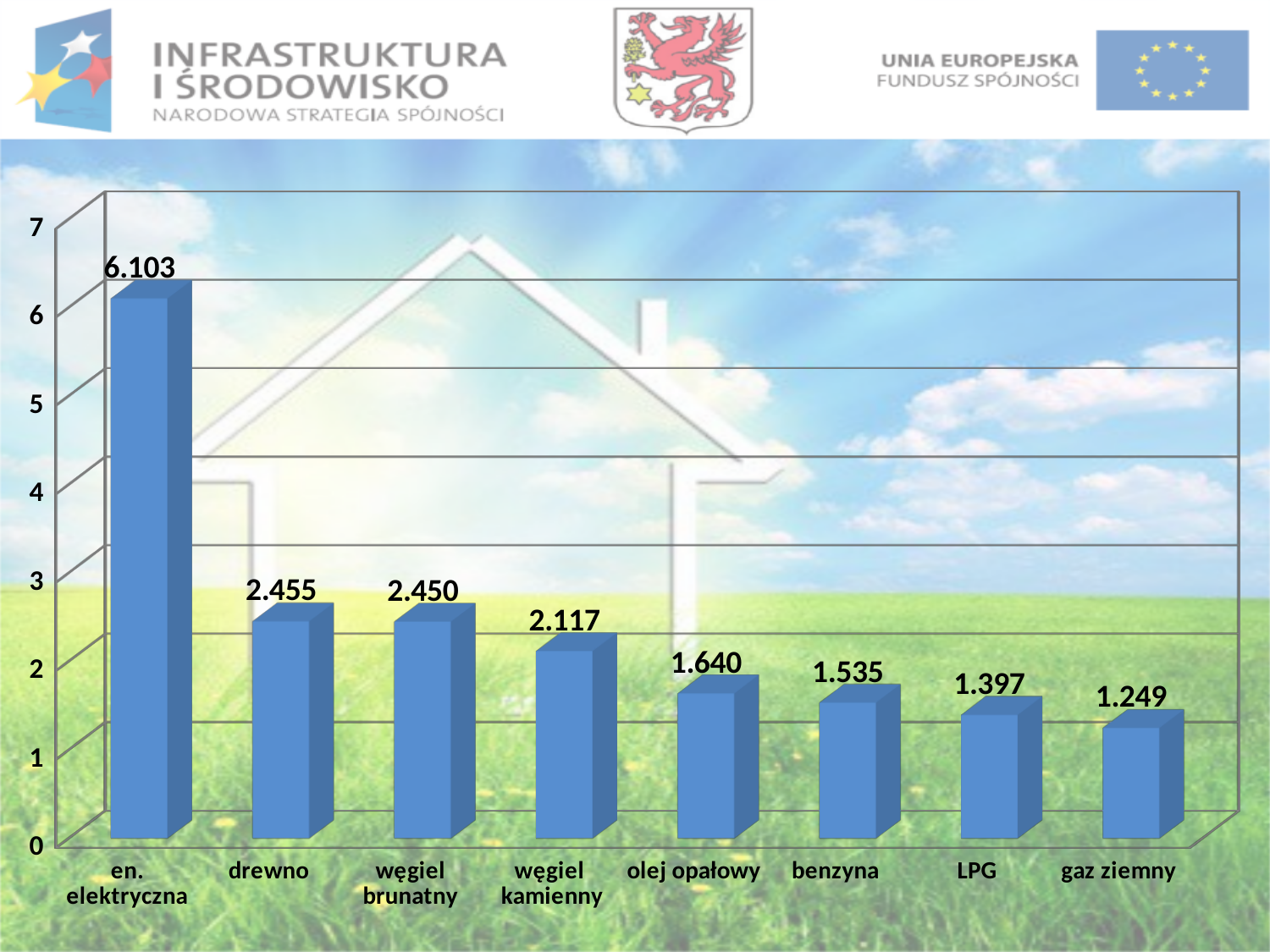
What is the value for LPG? 1.397 Is the value for drewno greater or less than 2? greater What kind of chart is shown on the slide? bar chart How many categories are shown on the x axis? 8 Which is larger, the value for benzyna or the value for węgiel kamienny? węgiel kamienny Which category has the lowest value? gaz ziemny What is the value for en. elektryczna? 6.103 Which category has the highest value? en. elektryczna What is the difference between the values for en. elektryczna and gaz ziemny? 4.854 What is the value for olej opałowy? 1.640 What is the difference between the values for węgiel kamienny and LPG? 0.720 What is the value for gaz ziemny? 1.249